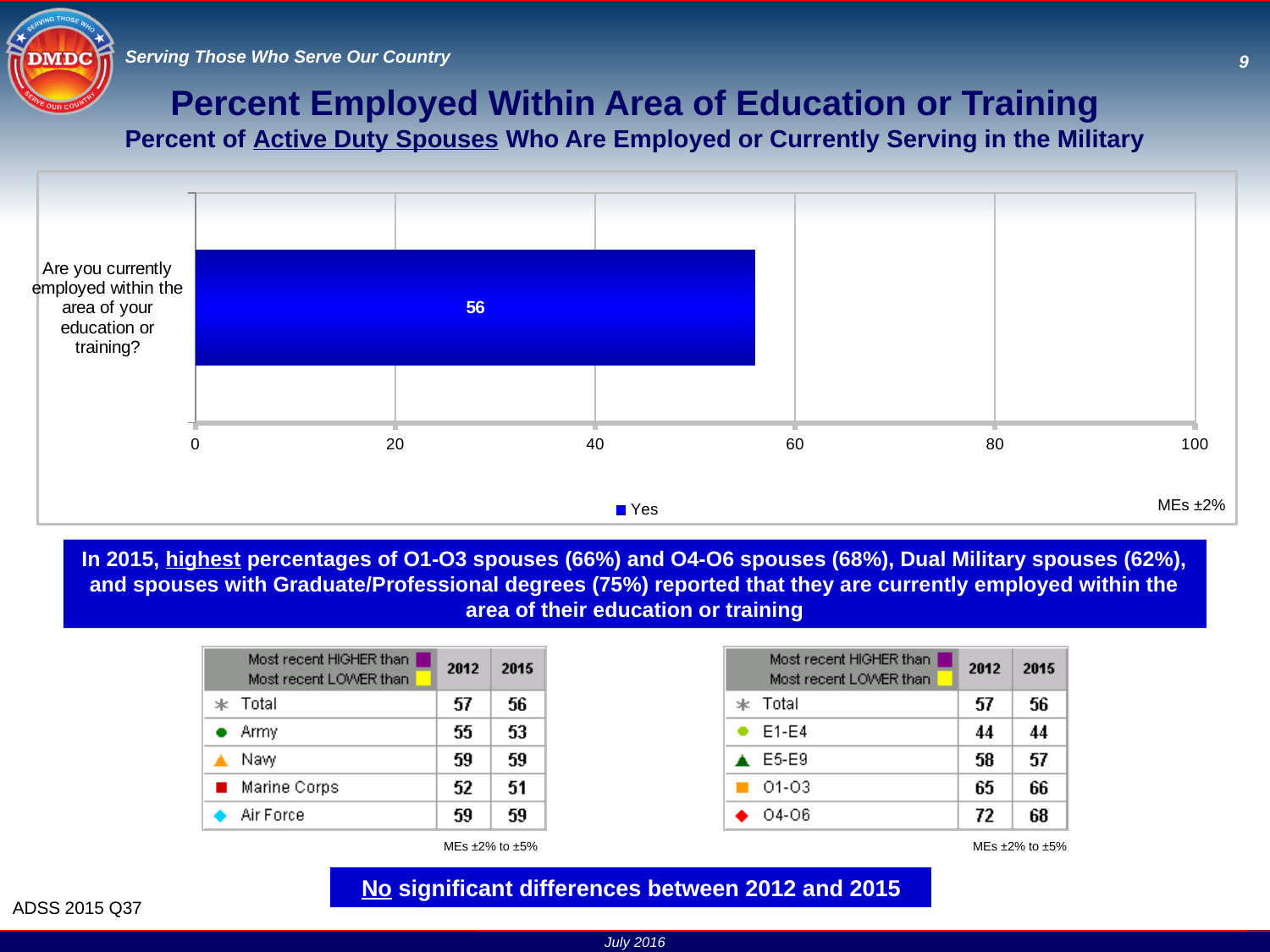
How many series does the chart legend list? 1 What is the maximum value shown on the chart's horizontal axis? 100 What is the value of the bar for "Are you currently employed within the area of your education or training?"? 56 How many bars are plotted in the chart? 1 What is the series name shown in the chart legend? Yes Is the value of the bar greater or less than 40? greater Is the value of the bar greater or less than 60? less What kind of chart is shown on the slide? bar chart